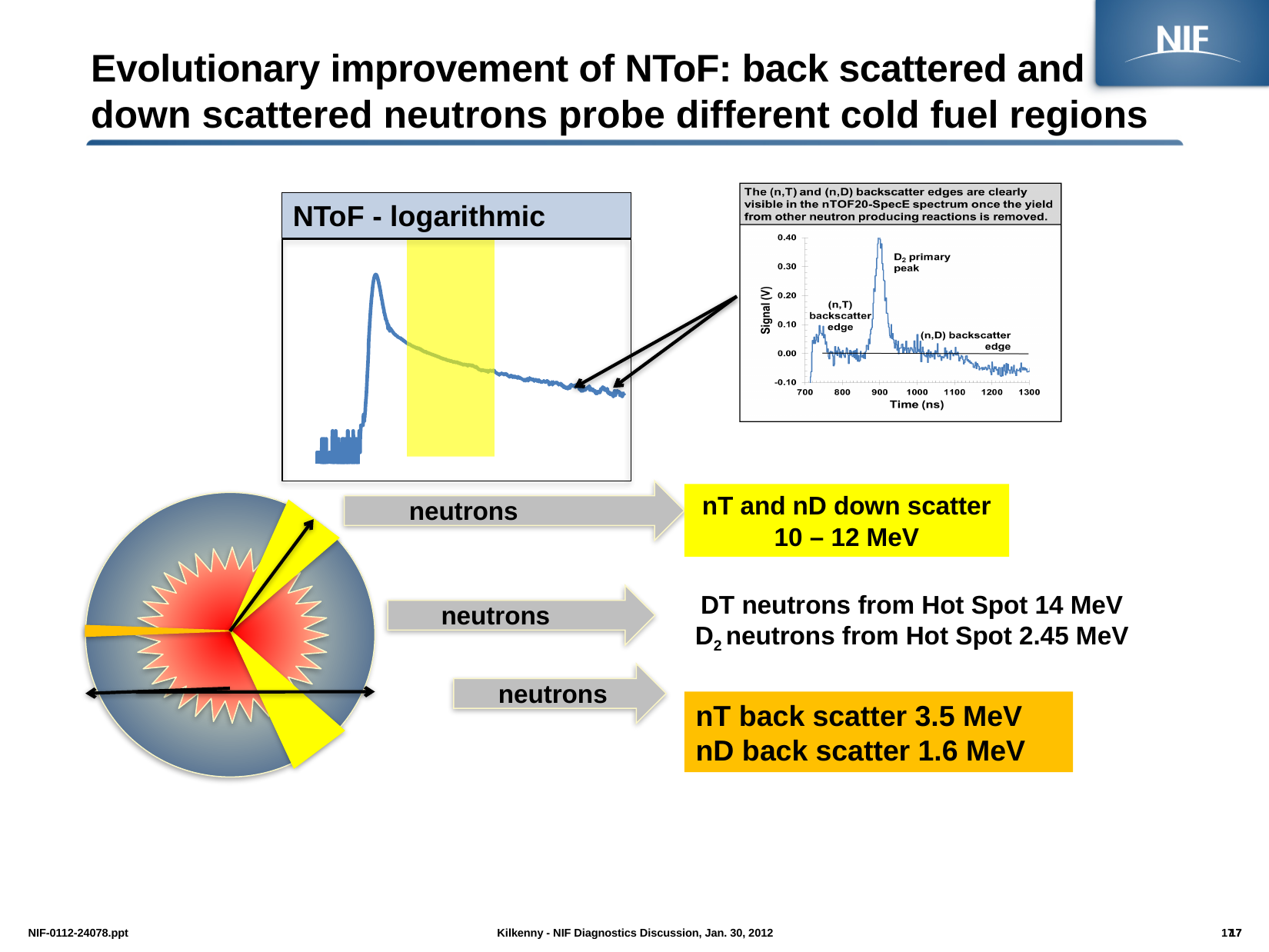
What type of chart is the 'NToF - logarithmic' chart on the left of the slide? line chart In the inset chart on the right, what is the label of the y axis? Signal (V) In the inset chart on the right, what is the label of the x axis? Time (ns) In the inset chart on the right, does the signal rise or fall between 900 ns and 1000 ns? fall What is the title of the chart on the left of the slide? NToF - logarithmic In the inset chart on the right, what is the last tick value on the Time (ns) axis? 1300 In the inset chart on the right, which labelled feature has the highest signal? D2 primary peak In the inset chart on the right, what is the highest value shown on the Signal (V) axis? 0.40 In the inset chart on the right, what is the first tick value on the Time (ns) axis? 700 In the inset chart on the right, is the signal at the D2 primary peak greater or less than 0.30 V? greater In the inset chart on the right, is the signal at the (n,T) backscatter edge greater or less than 0.20 V? less In the inset chart on the right, what is the lowest value shown on the Signal (V) axis? -0.10